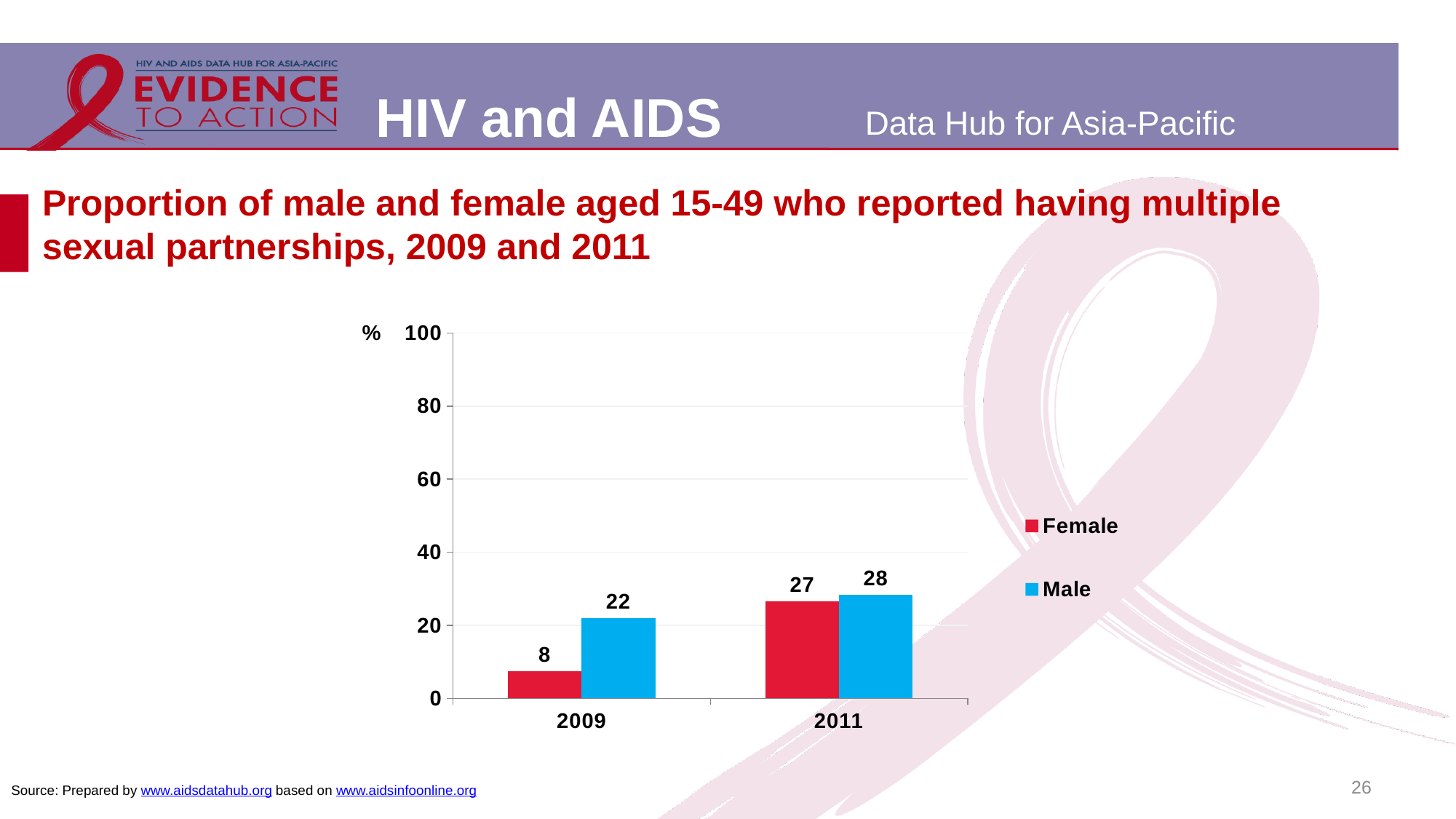
What is the value for Female in 2009? 8 How many series does the legend list? 2 Does the Female value rise or fall from 2009 to 2011? Rise What is the value for Female in 2011? 27 What is the value for Male in 2011? 28 Which year has the lowest Female value? 2009 What is the difference between the Male and Female values in 2009? 14 What kind of chart is shown on the slide? Bar chart What is the value for Male in 2009? 22 What is the difference between the Female values in 2011 and 2009? 19 Which is larger in 2009, the Male value or the Female value? Male Which year has the highest Male value? 2011